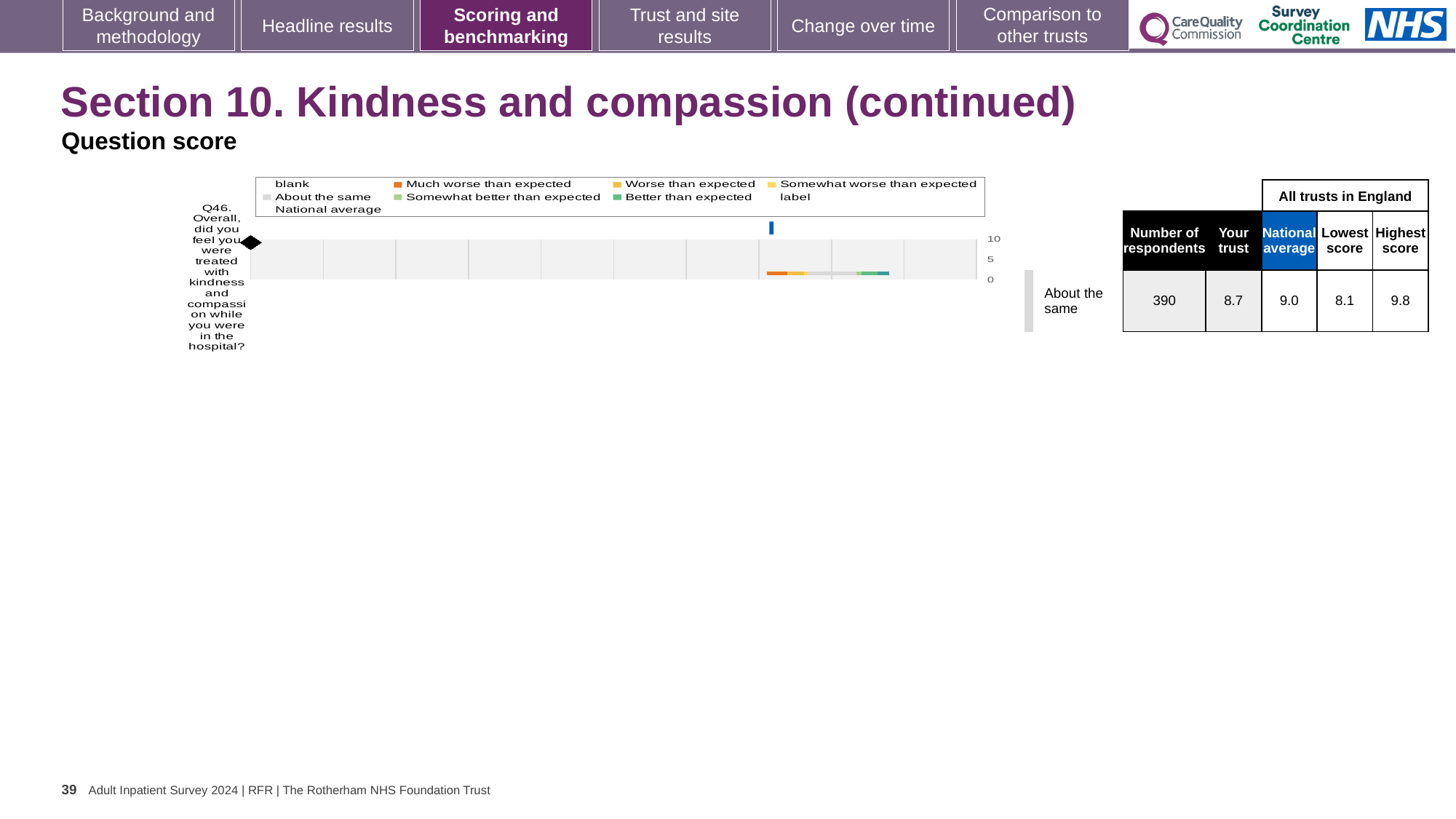
How many entries does the chart legend list? 9 How many questions (categories) are plotted in the chart? 1 Which legend entry is shown in orange? Much worse than expected What kind of chart is shown on the slide for Q46? bar chart Which is larger for Q46: the Your trust score or the National average score? National average In the table beside the chart, what is the score for Your trust for Q46? 8.7 What is the highest tick value shown on the chart's axis? 10 In the table beside the chart, what is the Highest score among all trusts in England for Q46? 9.8 What benchmark category is given for Q46 next to the chart? About the same In the table beside the chart, what is the National average score for Q46? 9.0 In the table beside the chart, what is the Lowest score among all trusts in England for Q46? 8.1 In the table beside the chart, how many respondents answered Q46? 390